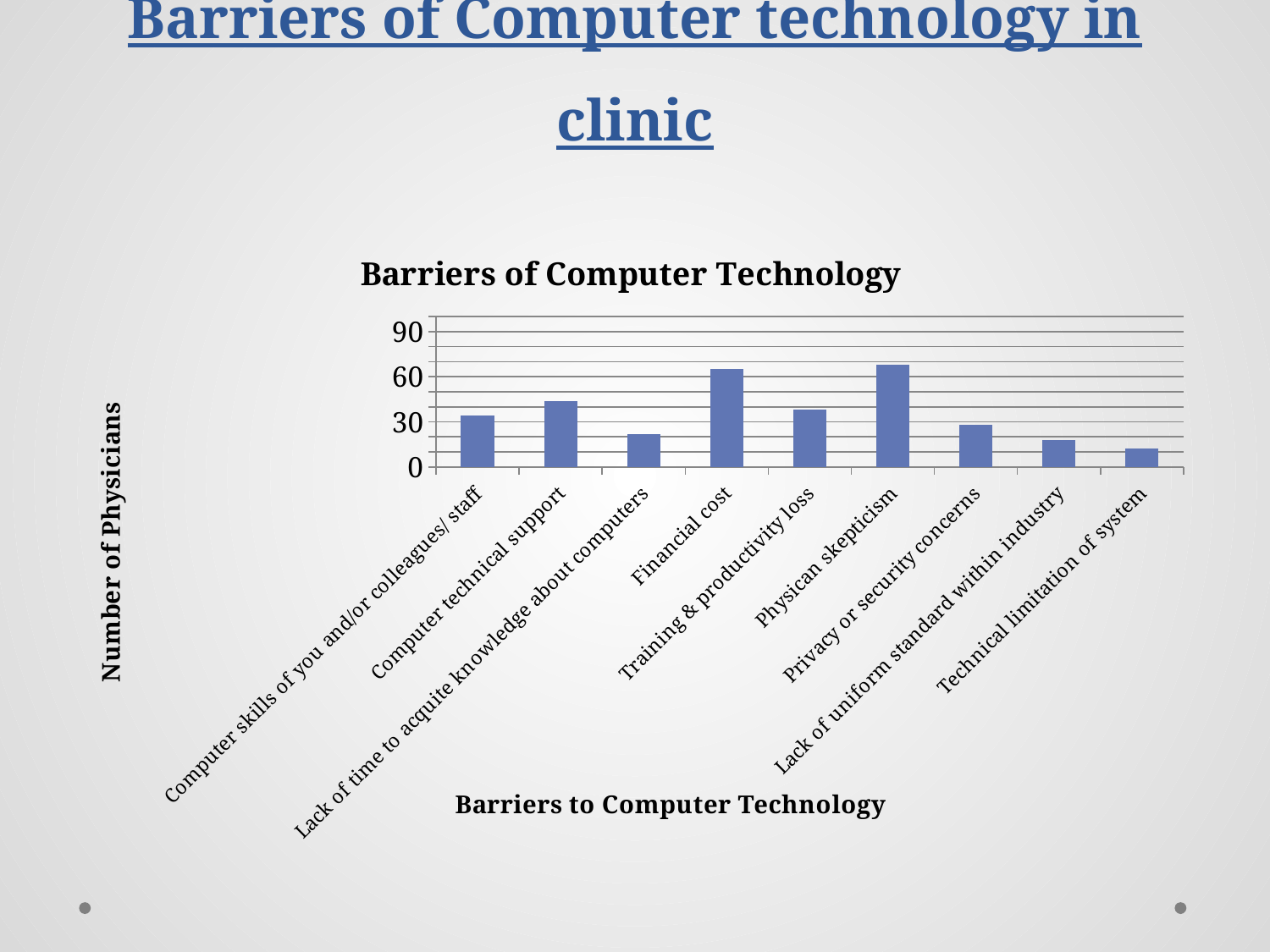
What is the title of the chart? Barriers of Computer Technology Is the value for Computer technical support greater or less than 30? greater Is the value for Lack of time to acquite knowledge about computers greater or less than 30? less Is the value for Financial cost greater or less than 60? greater Which is larger: the value for Training & productivity loss or the value for Technical limitation of system? Training & productivity loss How many barrier categories are plotted on the chart? 9 Which is larger: the value for Financial cost or the value for Computer skills of you and/or colleagues/ staff? Financial cost What is the label on the vertical axis of the chart? Number of Physicians What kind of chart is shown on the slide? Bar chart Which barrier has the lowest number of physicians? Technical limitation of system